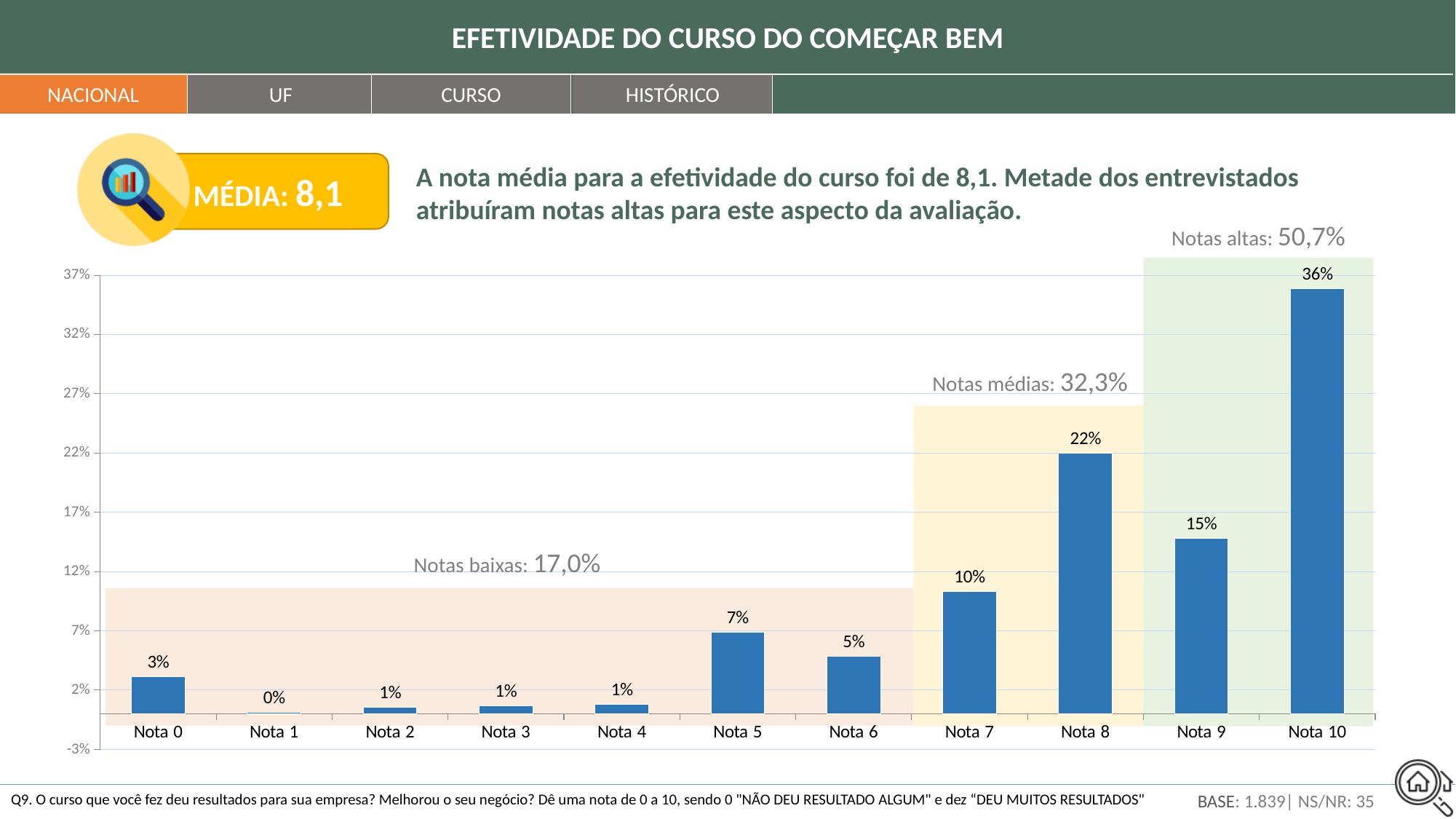
Which is larger, the value for Nota 8 or the value for Nota 9? Nota 8 Which category has the highest value? Nota 10 What percentage is shown for 'Notas altas' on the chart? 50,7% What is the value for Nota 10? 36% What is the value for Nota 5? 7% Is the value for Nota 10 greater or less than 32%? greater What is the value for Nota 8? 22% What is the difference between the values for Nota 9 and Nota 7? 5% How many categories are shown on the x axis? 11 What is the difference between the values for Nota 10 and Nota 8? 14% What kind of chart is shown on the slide? bar chart Which category has the lowest value? Nota 1